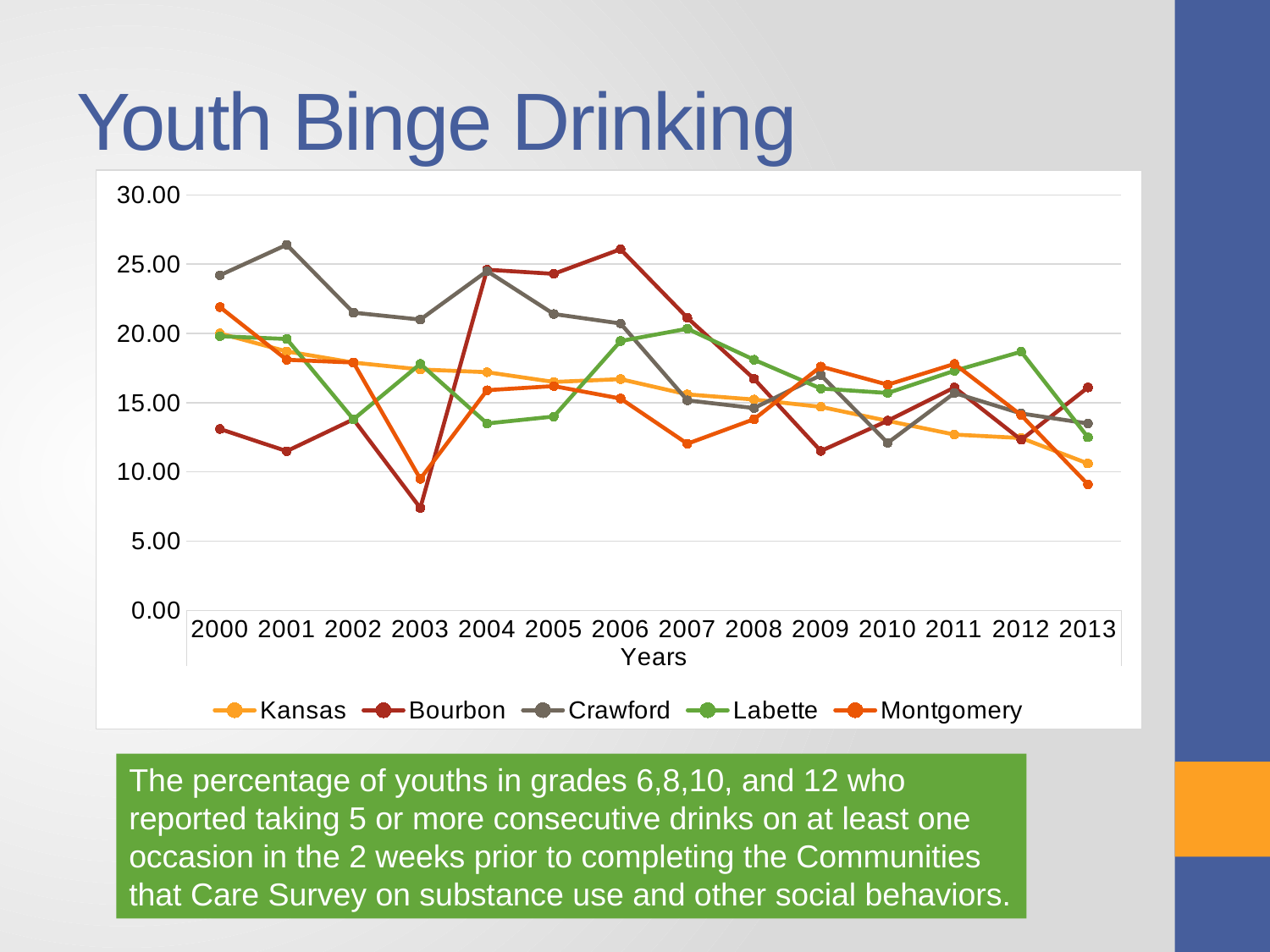
Does the Kansas line generally rise or fall from 2000 to 2013? fall What is the title of the x axis? Years How many series does the legend list? 5 Is the value for Bourbon in 2003 greater or less than 10.00? less Is the value for Crawford in 2001 greater or less than 25.00? greater In 2000, which is larger, the value for Crawford or the value for Bourbon? Crawford Which series has the highest value in 2006? Bourbon In which year does the Crawford line reach its highest value? 2001 What kind of chart is shown on the slide? line chart How many years are shown along the x axis? 14 Which series has the lowest value in 2003? Bourbon Is the value for Montgomery in 2013 greater or less than 10.00? less